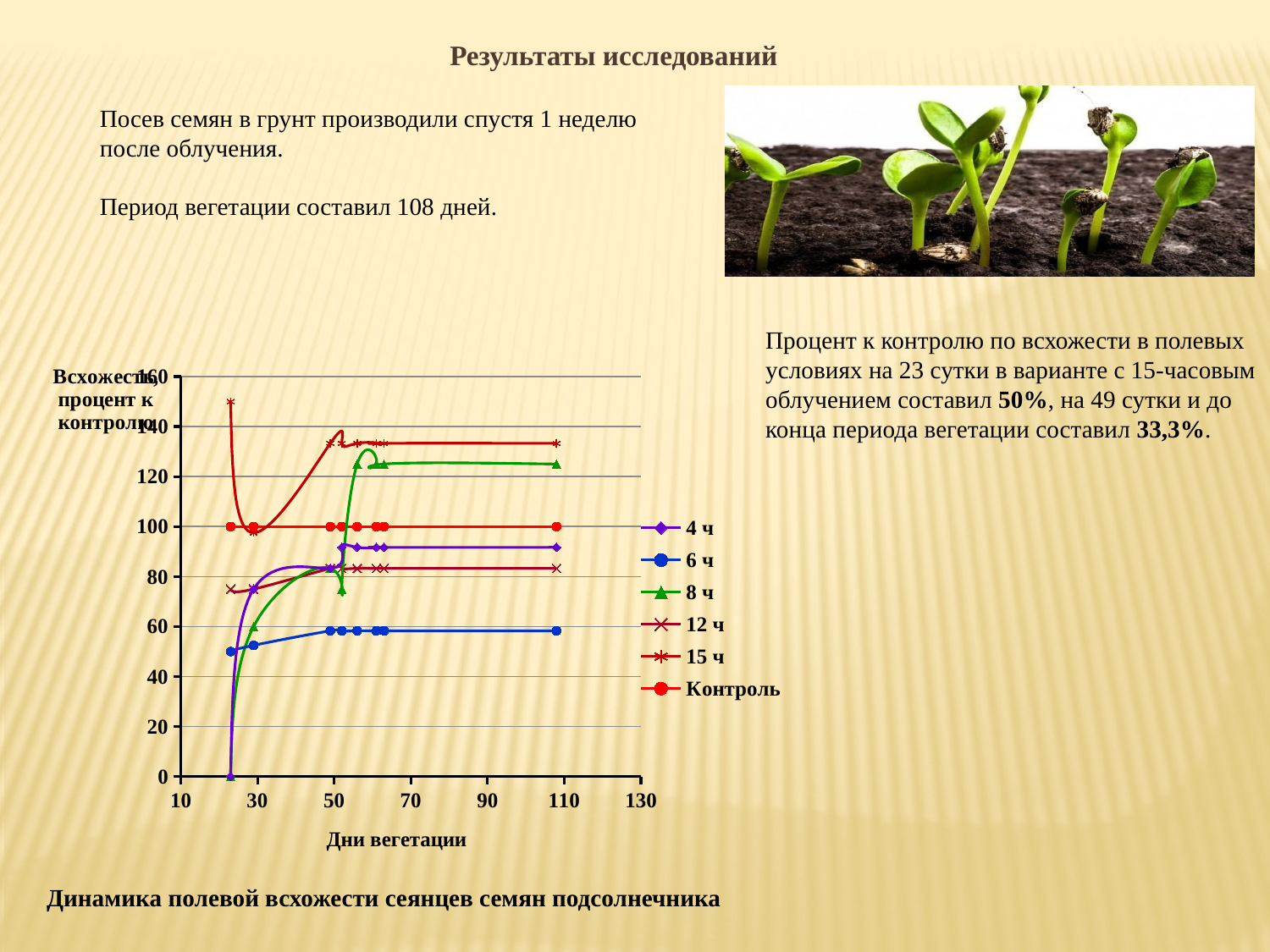
Is the value for the 6 ч series at about day 23 greater or less than 60? less Which series has the highest value at the end of the vegetation period (around day 108)? 15 ч Which legend entry is drawn in red with circle markers? Контроль Is the value for the 8 ч series at about day 108 greater or less than 120? greater How many series does the chart legend list? 6 At about day 108, which series has the larger value: 8 ч or 6 ч? 8 ч What kind of chart is shown on the slide? line chart Is the value for the 15 ч series at about day 23 greater or less than 140? greater What value does the Контроль series hold across the vegetation period? 100 Does the 6 ч series rise or fall as the days of vegetation increase? rise What is the title of the x axis of the chart? Дни вегетации Which series has the lowest value at the end of the vegetation period (around day 108)? 6 ч